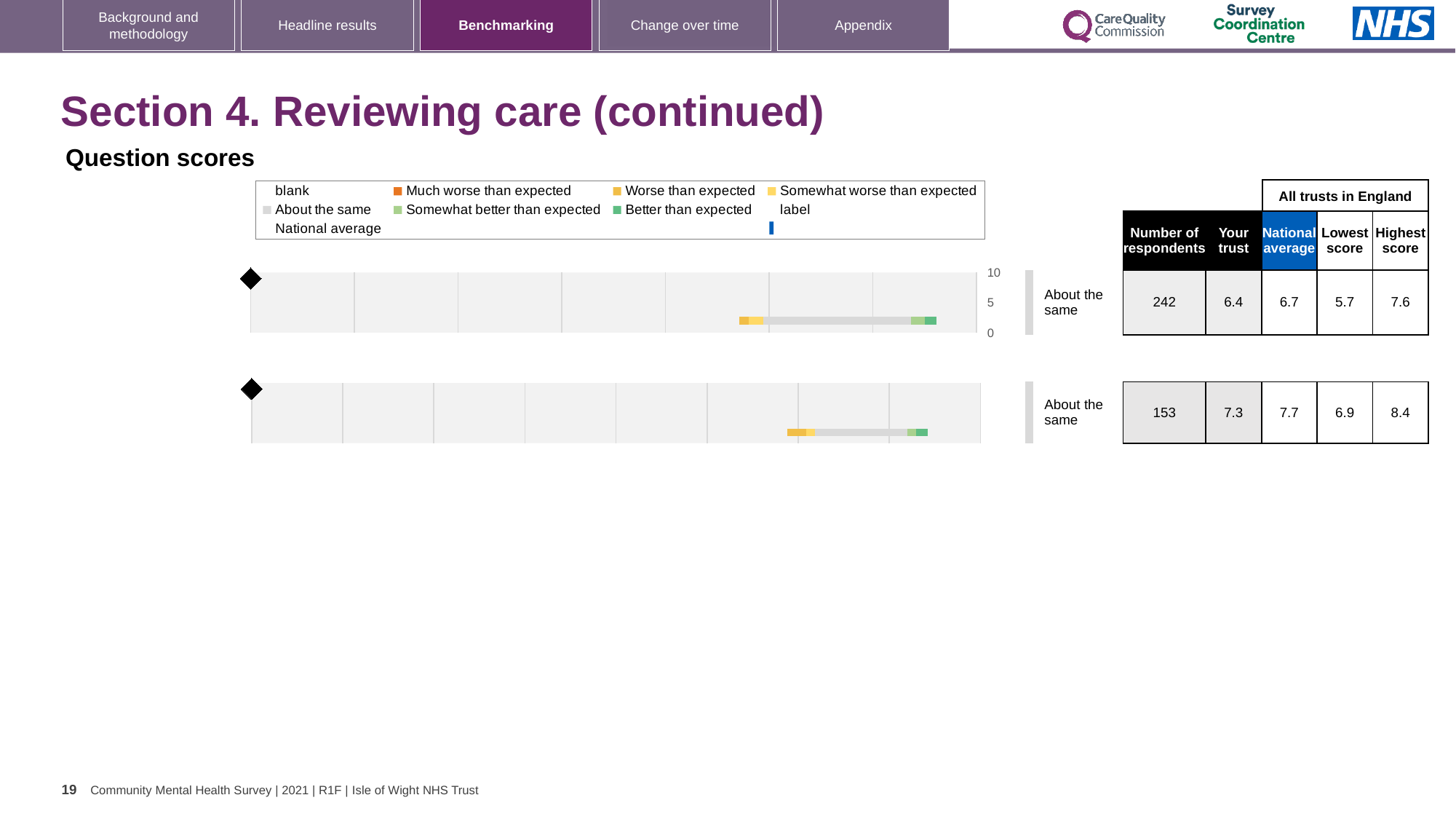
For the top chart, what is the national average score shown in the table? 6.7 What benchmark category label is shown next to the bottom chart? About the same How many benchmarking charts are shown on the slide? 2 For the bottom chart, what is the highest score across all trusts in England? 8.4 For the bottom chart, what is the difference between the highest score and the lowest score? 1.5 For the top chart, how many respondents are listed? 242 What kind of chart is the top chart on the slide? bar chart For the bottom chart, how many respondents are listed? 153 For the bottom chart, what is the 'Your trust' score shown in the table? 7.3 For the top chart, what is the difference between the national average and the 'Your trust' score? 0.3 For the top chart, is the 'Your trust' score higher or lower than the national average? lower For the top chart, what is the 'Your trust' score shown in the table? 6.4